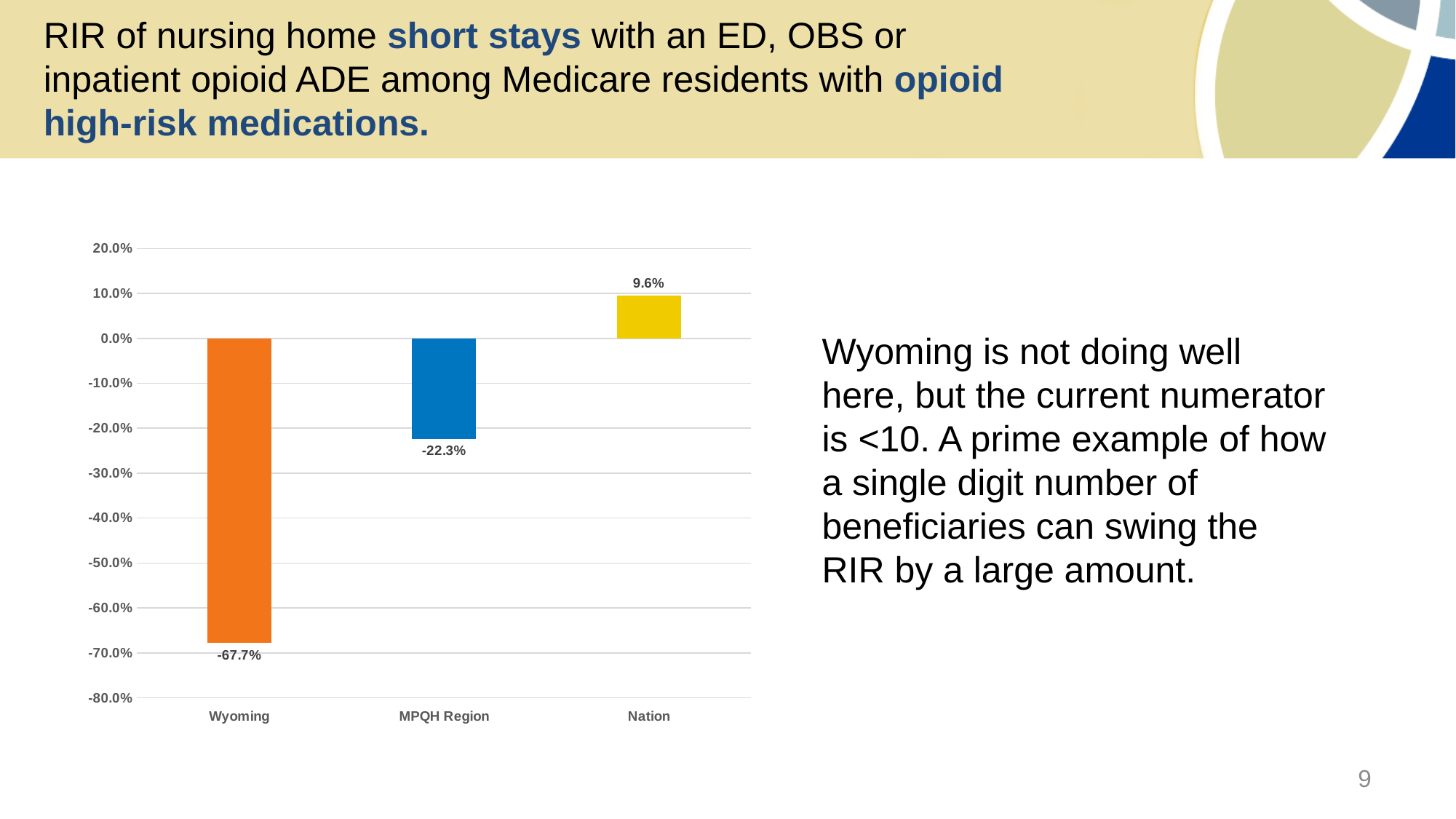
What kind of chart is shown on the slide? bar chart What colour is the bar for Nation? yellow What is the value for MPQH Region? -22.3% What is the value for Wyoming? -67.7% How many categories are shown on the x axis? 3 Which category has the lowest value? Wyoming Which category has the highest value? Nation What is the difference between the values for MPQH Region and Wyoming? 45.4% What is the difference between the values for Nation and MPQH Region? 31.9% Which is larger, the value for Wyoming or the value for MPQH Region? MPQH Region Is the value for Wyoming greater or less than -60.0%? less What is the value for Nation? 9.6%